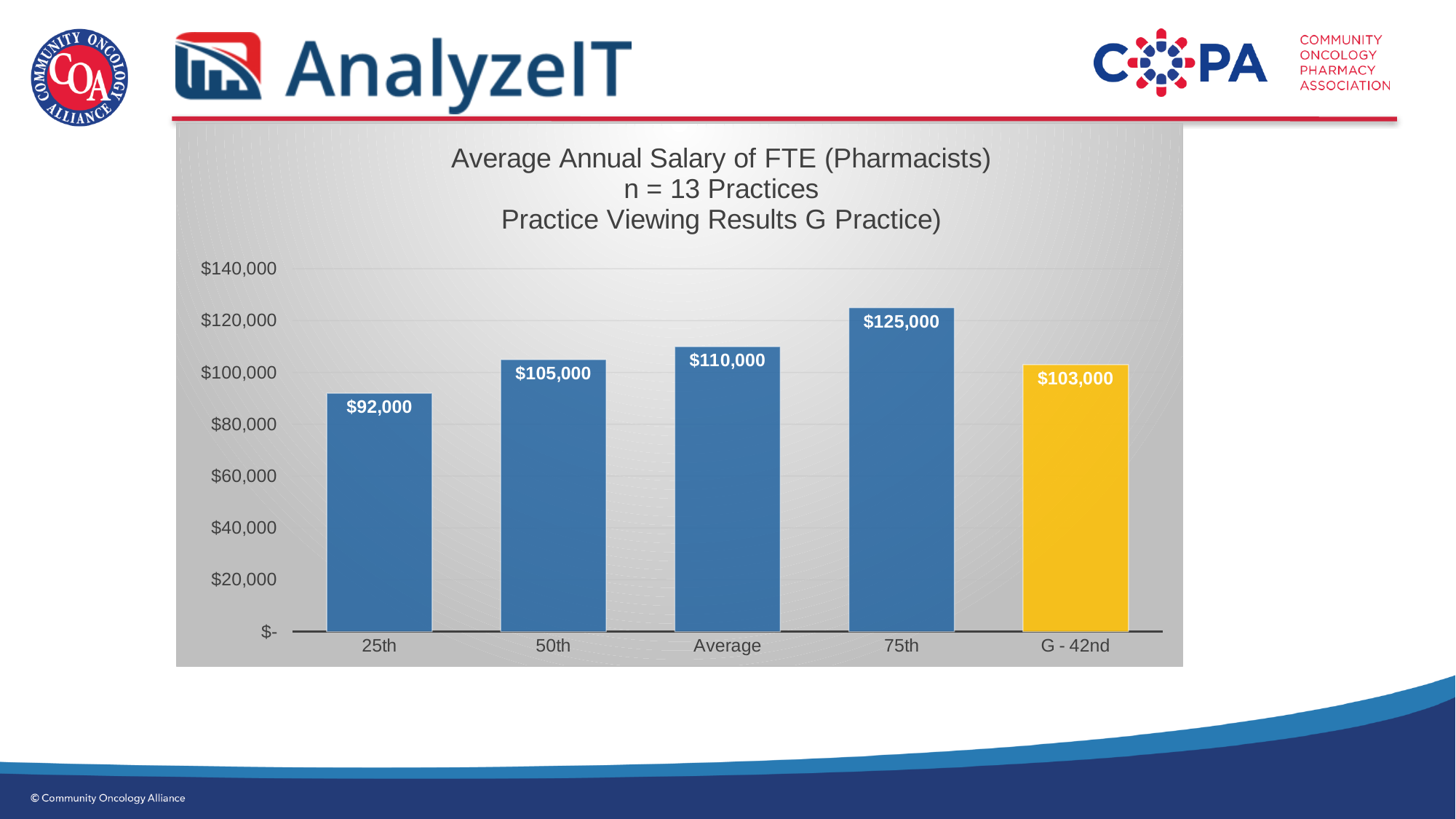
What is the value for the 50th category? $105,000 Is the value for 50th greater or less than $100,000? greater What is the value for the 25th category? $92,000 Which category has the lowest value? 25th How many categories are shown on the x axis? 5 What is the difference between the 75th value and the 25th value? $33,000 What is the value for the G - 42nd category? $103,000 What kind of chart is shown on the slide? bar chart Which bar is coloured differently (yellow) from the others? G - 42nd Which category has the highest value? 75th What is the value for the Average category? $110,000 Which is larger, the value for Average or the value for G - 42nd? Average